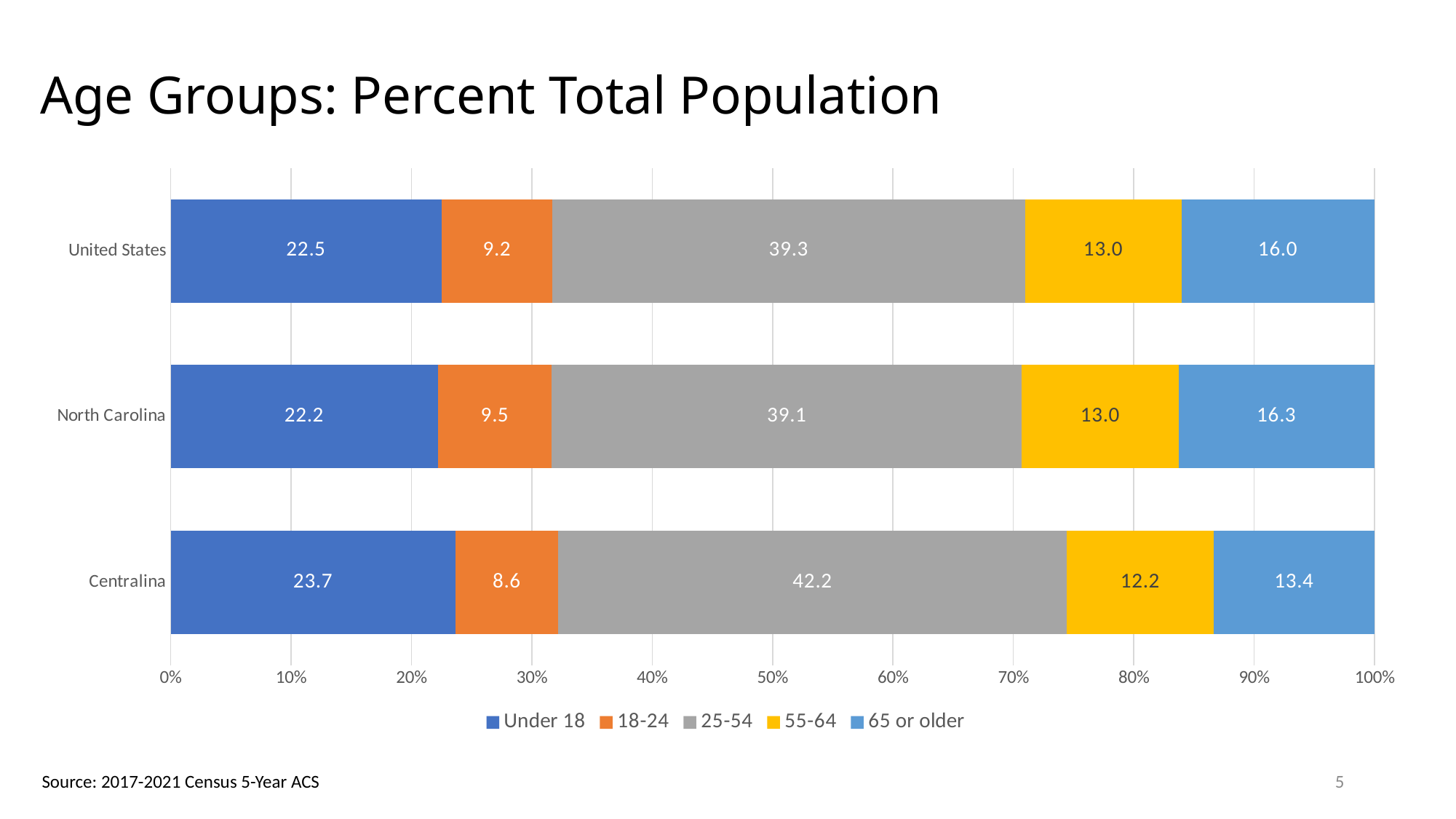
What is the value for the 25-54 age group for Centralina? 42.2 How many regions are shown on the chart? 3 What kind of chart is shown on the slide? Stacked bar chart What is the difference between the Under 18 values for Centralina and North Carolina? 1.5 Which is larger, the 18-24 value for North Carolina or for the United States? North Carolina What is the title of the chart? Age Groups: Percent Total Population What is the value for the 65 or older age group for North Carolina? 16.3 What is the value for the 18-24 age group for the United States? 9.2 Which region has the highest value for the 25-54 age group? Centralina What is the difference between the 25-54 values for Centralina and the United States? 2.9 Which region has the lowest value for the 65 or older age group? Centralina How many age groups does the legend list? 5